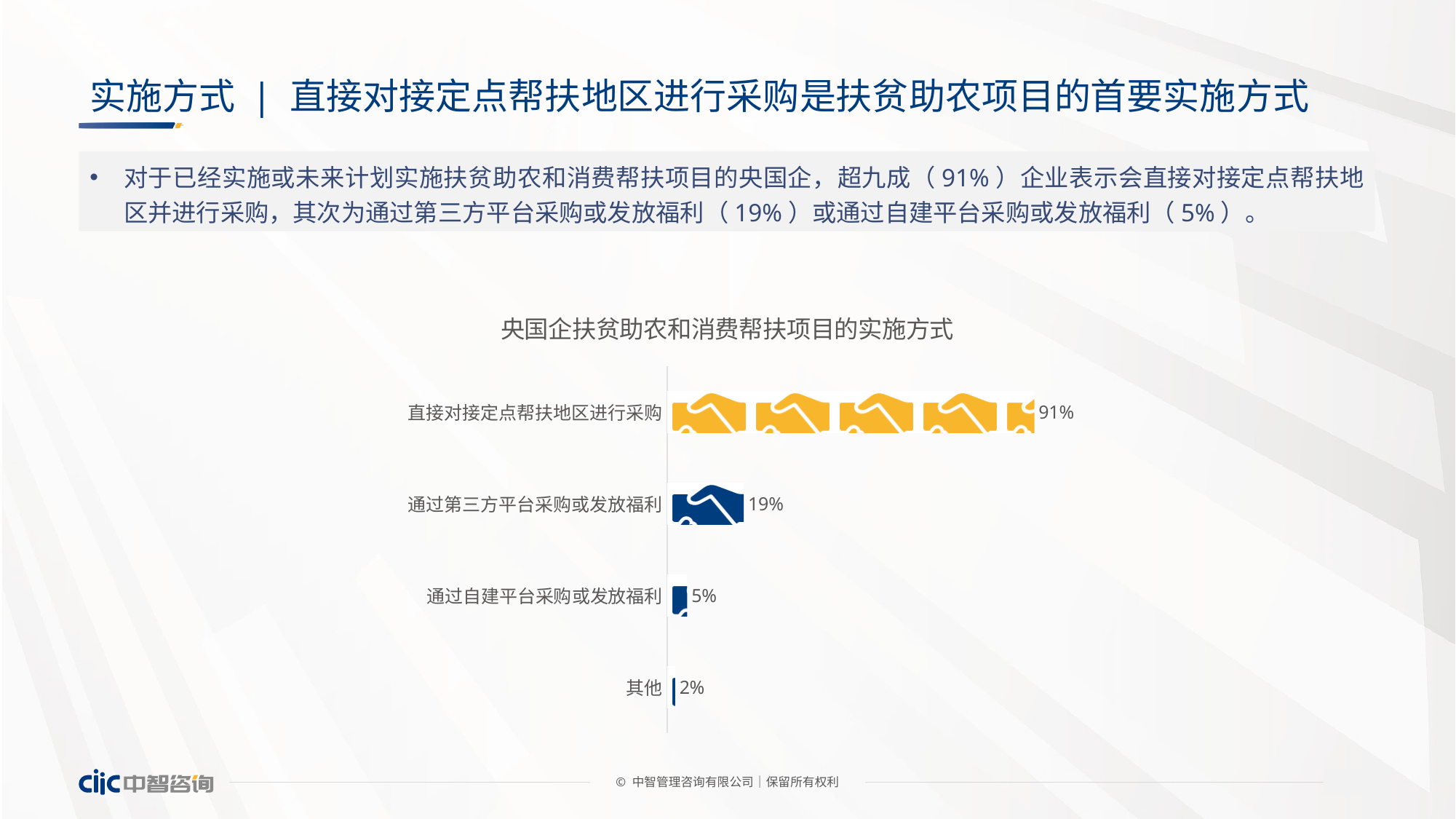
What is the difference between the values for 直接对接定点帮扶地区进行采购 and 通过第三方平台采购或发放福利? 72% What is the value for 其他? 2% What is the value for 直接对接定点帮扶地区进行采购? 91% Which is larger, the value for 通过第三方平台采购或发放福利 or the value for 通过自建平台采购或发放福利? 通过第三方平台采购或发放福利 What is the value for 通过自建平台采购或发放福利? 5% Which category has the lowest value? 其他 How many categories are shown in the chart? 4 What kind of chart is shown on the slide? Bar chart What is the difference between the values for 通过自建平台采购或发放福利 and 其他? 3% What is the value for 通过第三方平台采购或发放福利? 19% Which category has the highest value? 直接对接定点帮扶地区进行采购 What is the title of the chart? 央国企扶贫助农和消费帮扶项目的实施方式